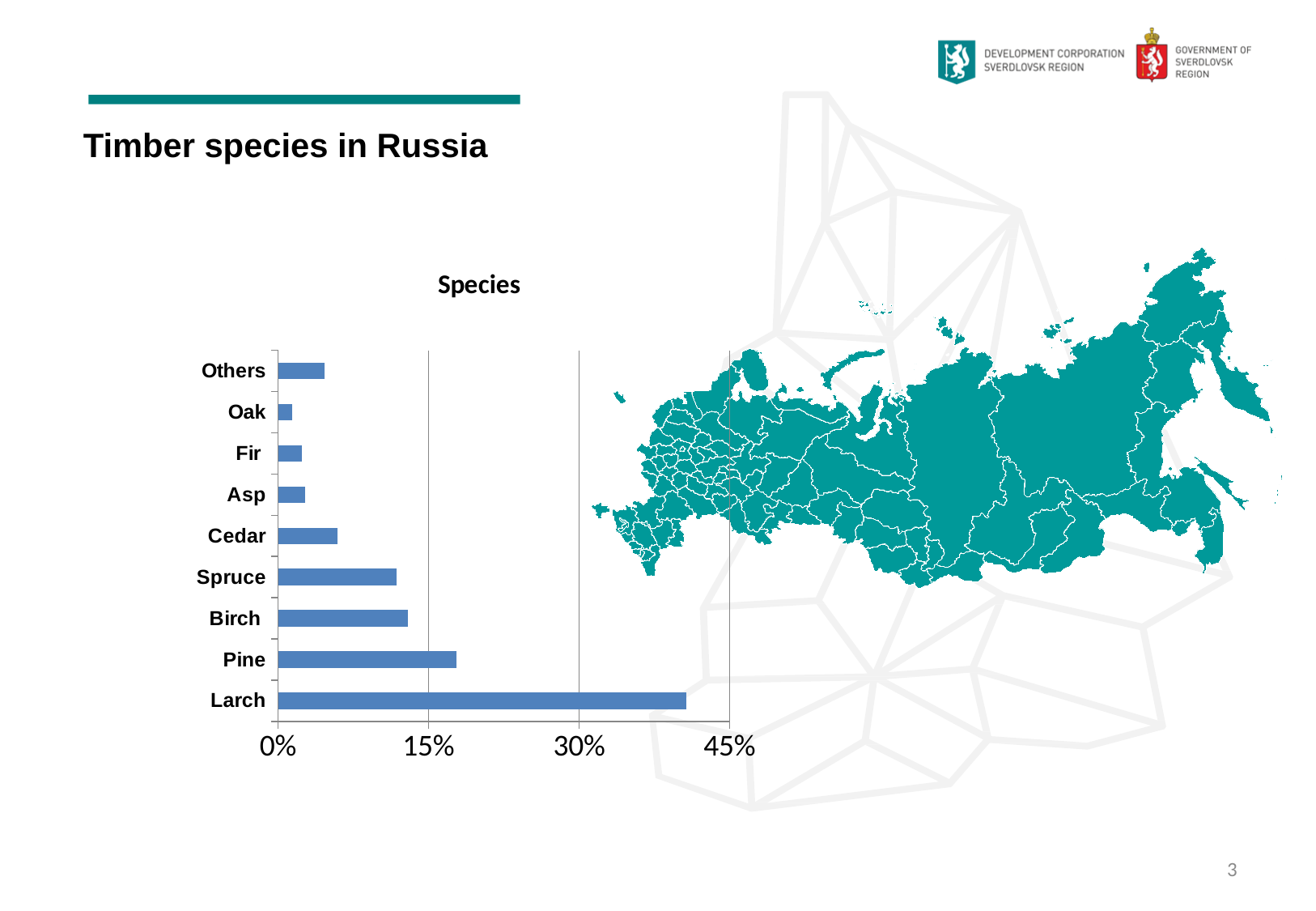
Which has the larger share, Cedar or Spruce? Spruce What is the title of the chart? Species Which has the larger share, Pine or Birch? Pine Is the value for Larch greater or less than 45%? less Which species has the highest share in the chart? Larch Which species has the lowest share in the chart? Oak How many timber species categories are plotted in the chart? 9 Is the value for Birch greater or less than 15%? less Is the value for Larch greater or less than 30%? greater What kind of chart is shown on the slide? bar chart